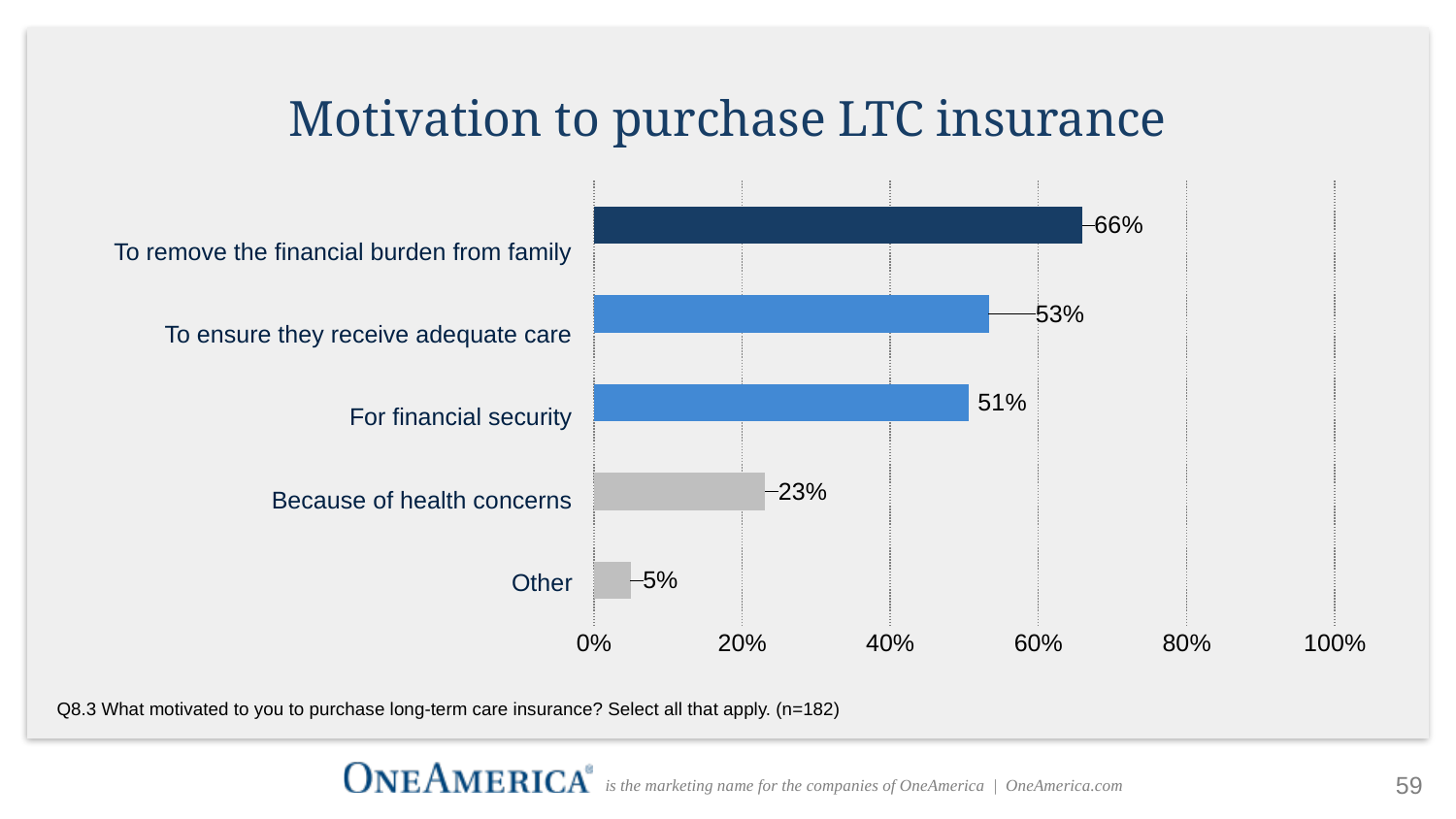
What is the value shown for 'Because of health concerns'? 23% What is the title of the chart? Motivation to purchase LTC insurance Which motivation has the highest percentage? To remove the financial burden from family What is the value shown for 'Other'? 5% What type of chart is shown on the slide? Bar chart Which is larger: the value for 'For financial security' or the value for 'Because of health concerns'? For financial security Which motivation has the lowest percentage? Other What percentage of respondents cited 'To remove the financial burden from family' as a motivation to purchase LTC insurance? 66% What is the difference between 'To remove the financial burden from family' and 'Because of health concerns'? 43 percentage points What is the difference in percentage points between 'To ensure they receive adequate care' and 'For financial security'? 2 percentage points How many motivation categories are shown in the chart? 5 Is the value for 'To ensure they receive adequate care' greater or less than 40%? greater